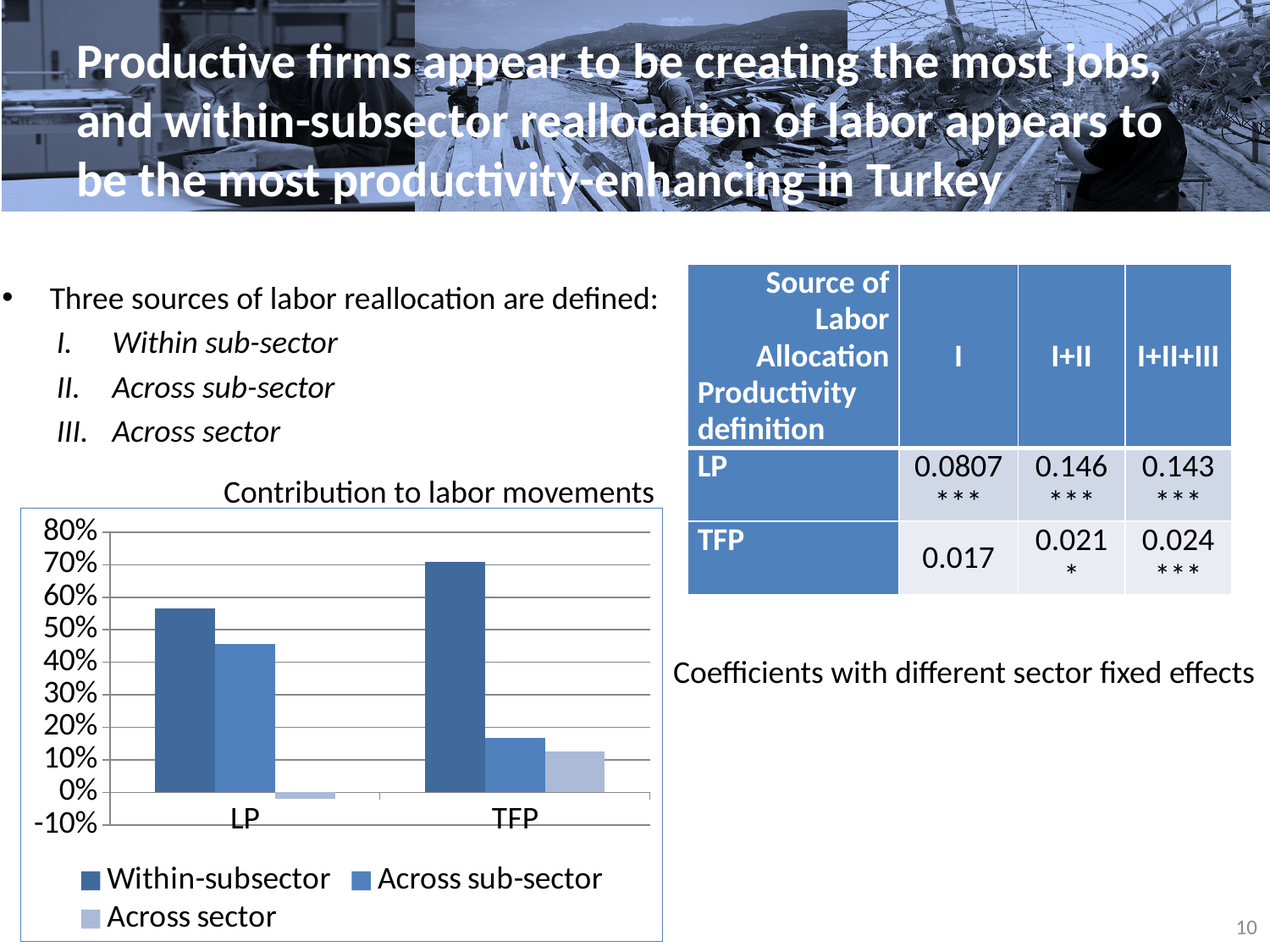
Is the Across sub-sector value for TFP greater or less than 20%? less What is the title of the chart on the slide? Contribution to labor movements Which series has the lowest value for LP? Across sector How many series does the chart's legend list? 3 What kind of chart is shown on the slide? bar chart Is the Within-subsector value for LP greater or less than 50%? greater Which category has the larger Within-subsector value, LP or TFP? TFP Is the Across sector value for LP greater or less than 10%? less Which category has the larger Across sub-sector value, LP or TFP? LP Which series has the highest value for TFP? Within-subsector How many categories are shown on the x axis of the chart? 2